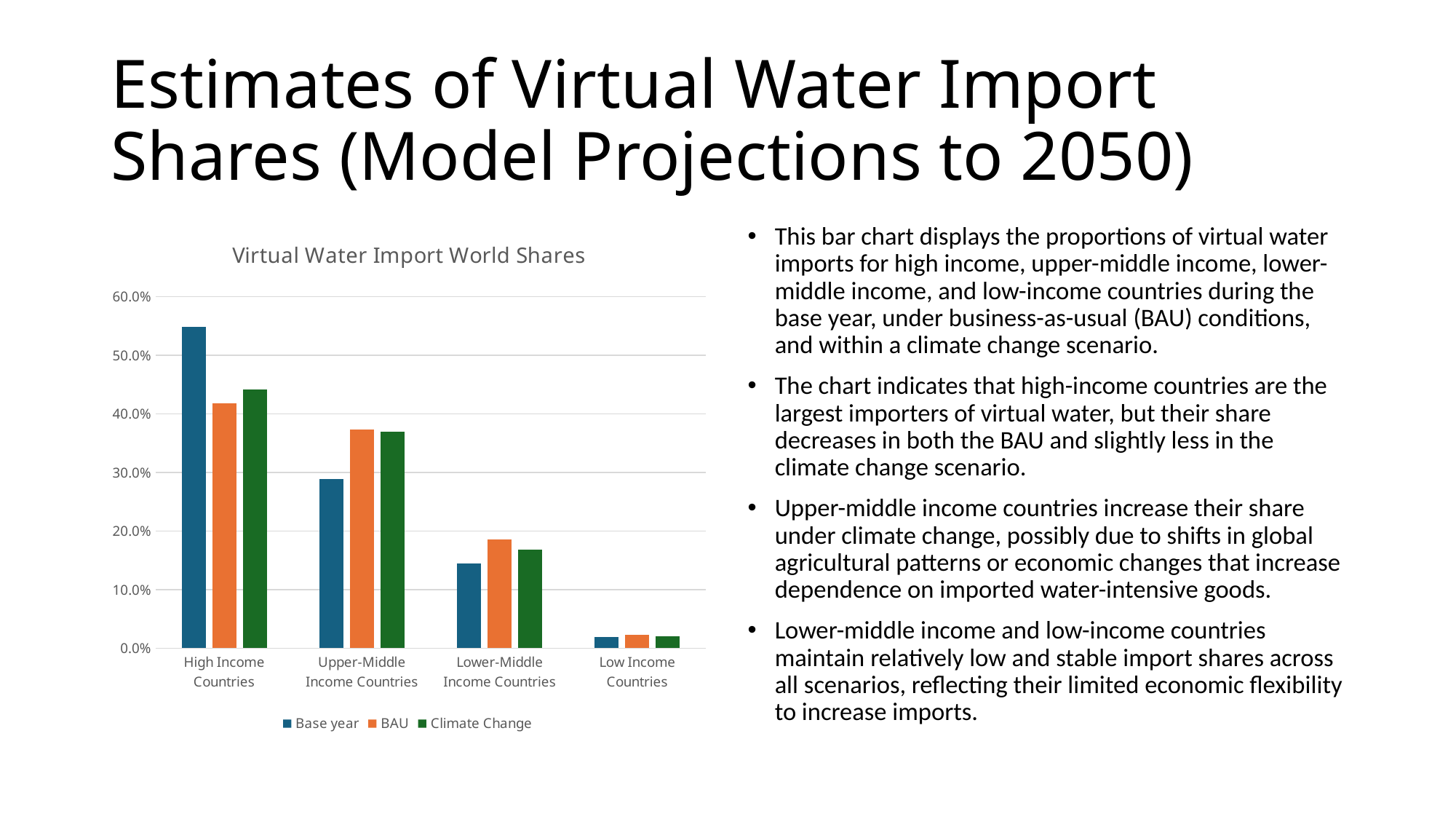
How many series does the chart legend list? 3 What type of chart is shown on the slide? bar chart Which category has the highest Base year value? High Income Countries For Upper-Middle Income Countries, which is larger: the Base year value or the BAU value? BAU For High Income Countries, which is larger: the Base year value or the Climate Change value? Base year What is the title of the chart? Virtual Water Import World Shares Which category has the lowest BAU value? Low Income Countries Is the BAU value for Lower-Middle Income Countries greater or less than 20.0%? less Do the Base year values rise or fall moving from High Income Countries to Low Income Countries along the x axis? fall Is the Base year value for High Income Countries greater or less than 50.0%? greater Is the Base year value for Upper-Middle Income Countries greater or less than 30.0%? less How many country income categories are shown on the x axis? 4